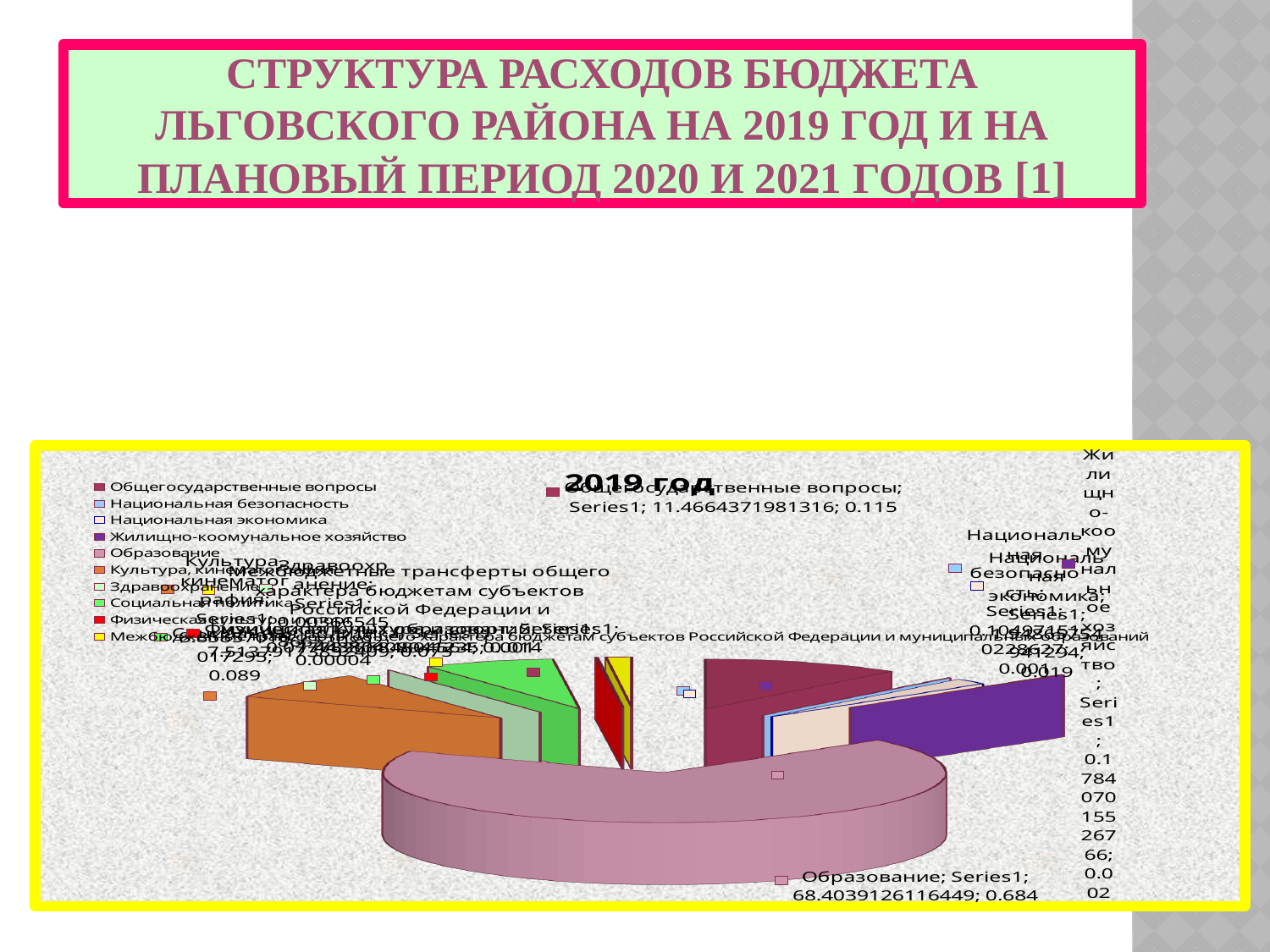
Which is larger, the slice for Образование or the slice for Общегосударственные вопросы? Образование What share of the pie is shown in the data label for Общегосударственные вопросы? 0.115 What kind of chart is shown on the slide? pie chart What is the title of the chart? 2019 год How many categories does the chart legend list? 10 Which category has the largest slice of the pie? Образование Is the share of the pie for Образование greater or less than 0.5? greater What value is shown in the data label for Общегосударственные вопросы? 11.4664371981316 What is the first category listed in the legend? Общегосударственные вопросы What is the difference between the share labels for Образование (0.684) and Общегосударственные вопросы (0.115)? 0.569 What share of the pie is shown in the data label for Образование? 0.684 What value is shown in the data label for Образование? 68.4039126116449